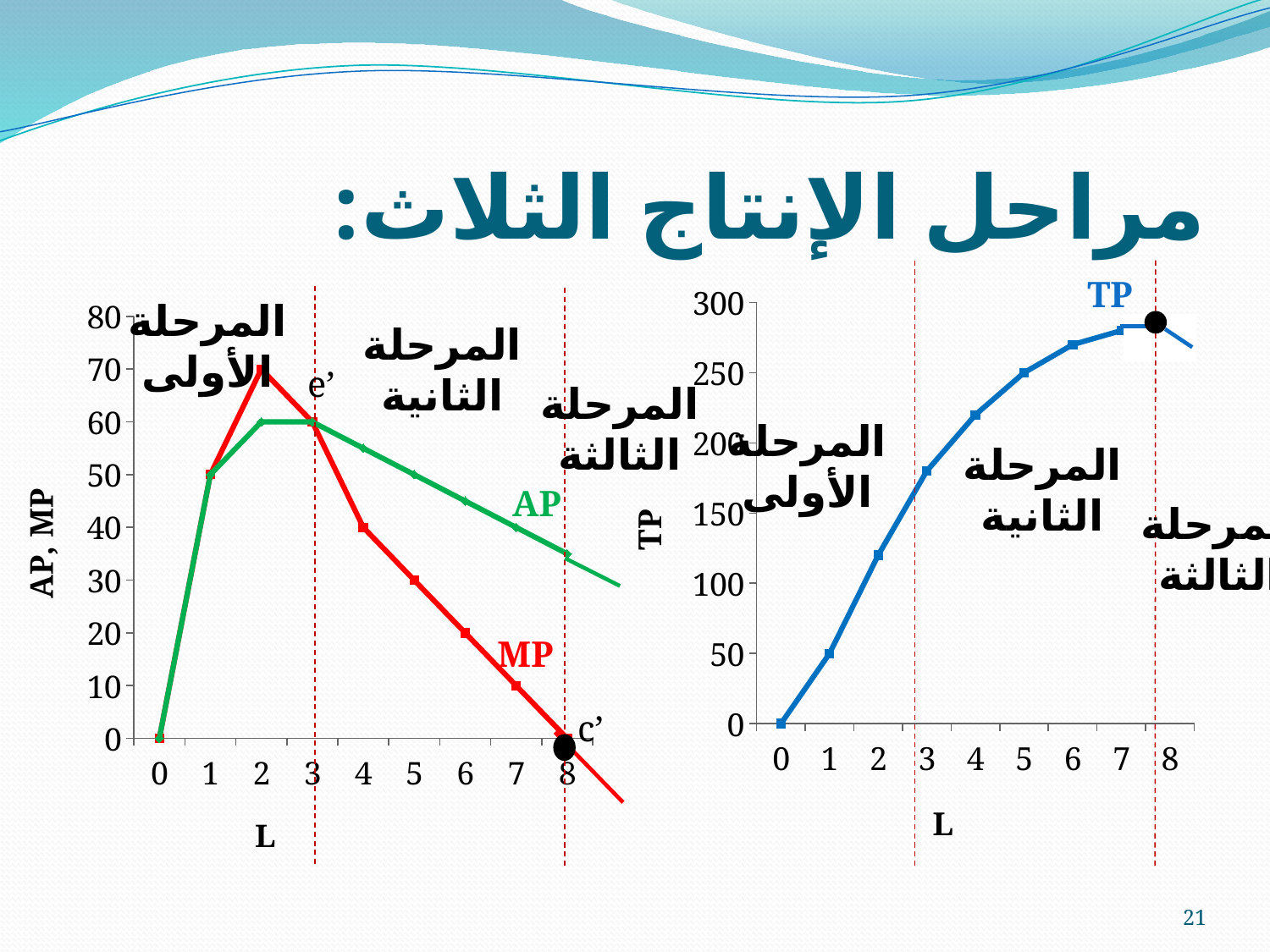
In the right chart (TP), is the value of TP at L = 4 greater or less than 200? greater In the left chart (AP, MP), what is the value of AP at L = 3? 60 In the right chart (TP), does TP rise or fall as L increases from 0 to 7? rise In the left chart (AP, MP), what is the difference between MP at L = 2 and MP at L = 3? 10 In the left chart (AP, MP), what is the value of MP at L = 2? 70 In the left chart (AP, MP), does MP rise or fall as L increases from 2 to 8? fall In the left chart (AP, MP), how many lines are plotted? 2 In the left chart (AP, MP), at which value of L does MP reach its highest point? 2 In the left chart (AP, MP), what is the value of MP at L = 8? 0 In the right chart (TP), what is the value of TP at L = 1? 50 What kind of chart is the left chart (AP, MP)? line chart In the left chart (AP, MP), at L = 6, which is larger, AP or MP? AP